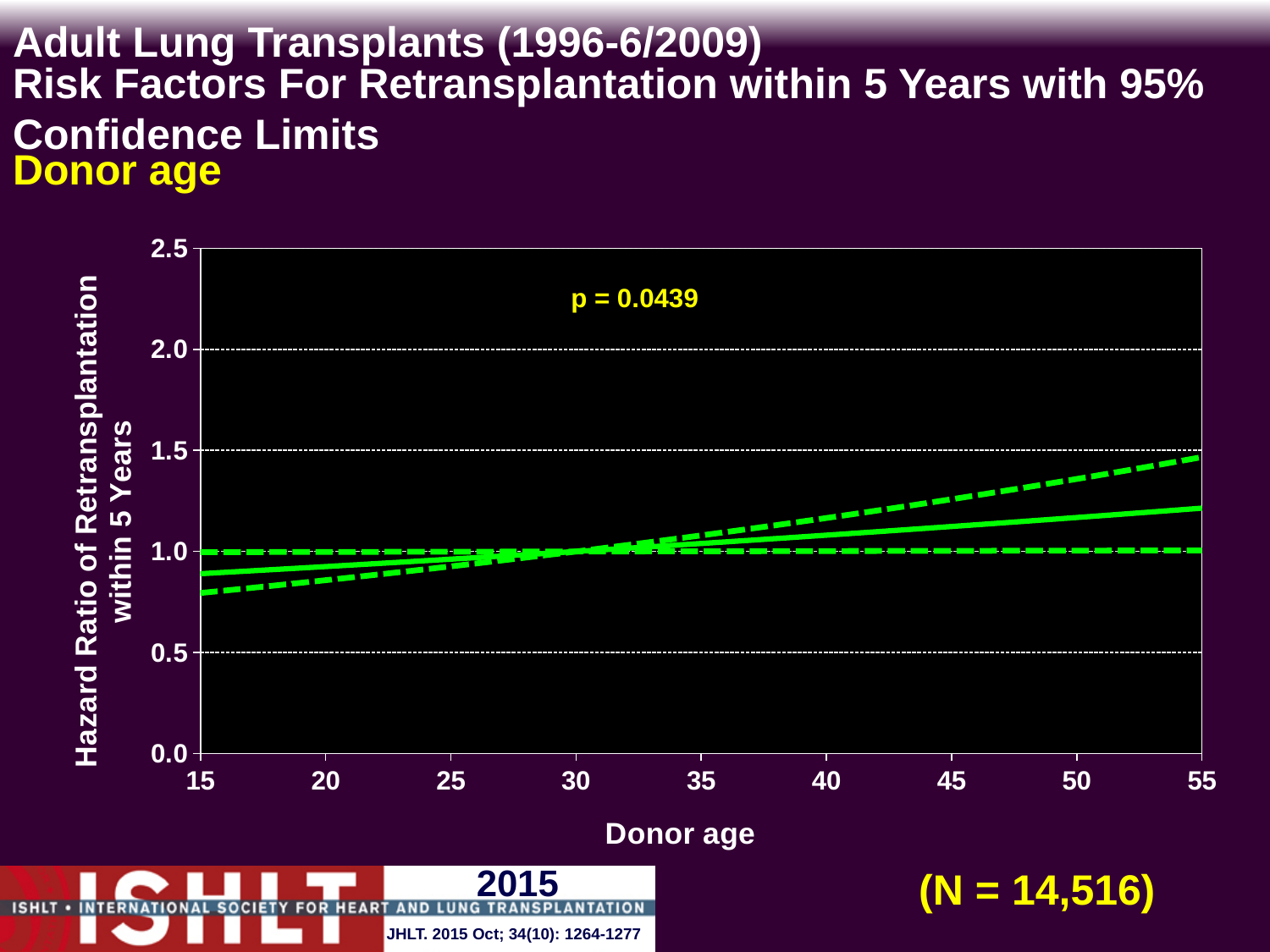
How many labelled tick marks are on the donor age (x) axis? 9 Is the hazard ratio (solid line) at donor age 55 greater or less than 1.0? greater What kind of chart is shown on the slide? line chart Is the hazard ratio (solid line) at donor age 15 greater or less than 1.0? less Is the hazard ratio (solid line) at donor age 55 greater or less than 1.5? less What sample size (N) is shown on the slide? N = 14,516 What p-value is printed on the chart? p = 0.0439 Does the solid hazard ratio line rise or fall as donor age increases from 15 to 55? rises Is the hazard ratio (solid line) at donor age 55 larger or smaller than at donor age 15? larger